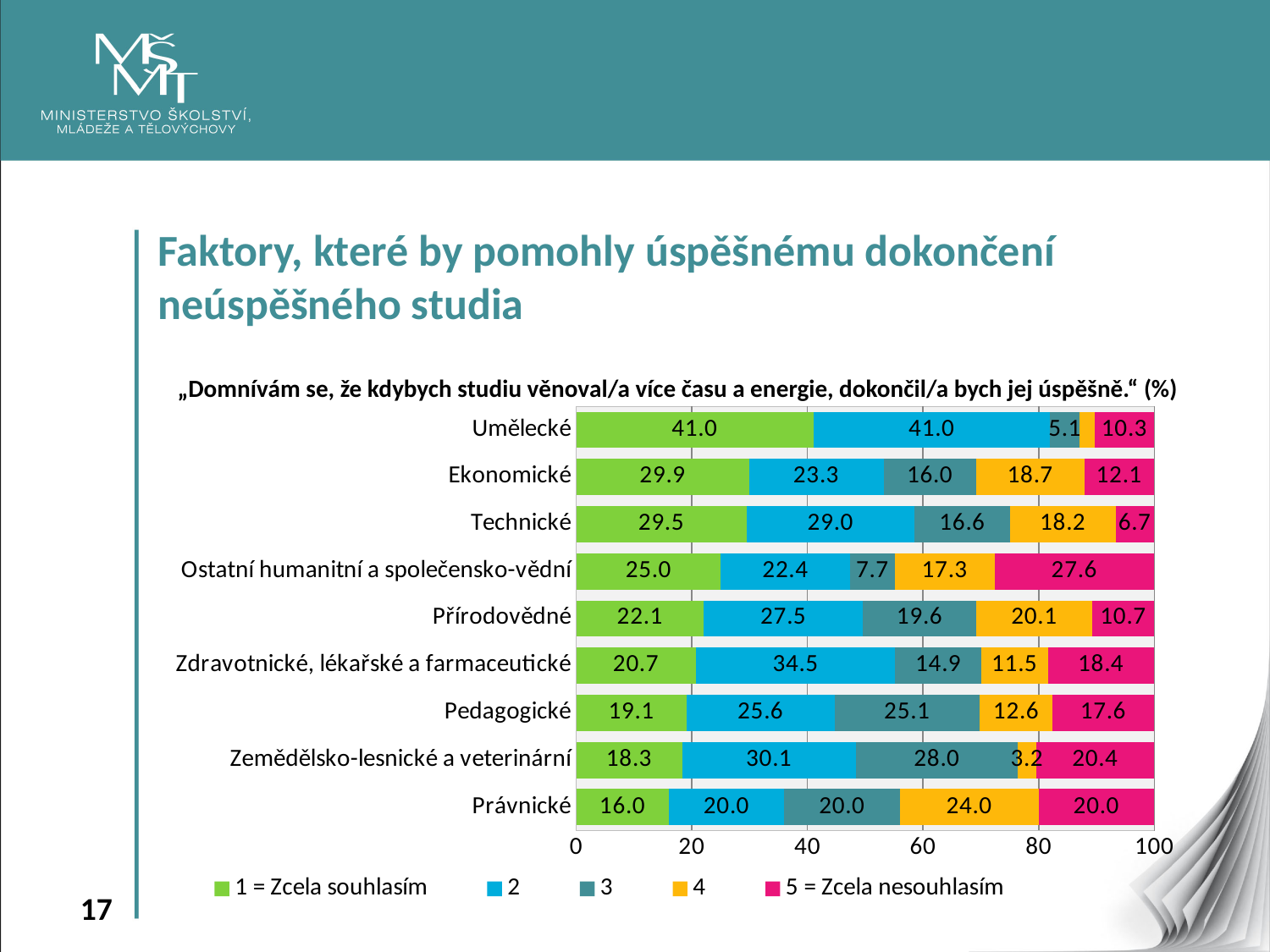
For Technické, what is the difference between the value of series "2" and series "3"? 12.4 What kind of chart is shown on the slide? Stacked bar chart What is the value of "5 = Zcela nesouhlasím" for Ostatní humanitní a společensko-vědní? 27.6 Which category has the lowest value for "1 = Zcela souhlasím"? Právnické What is the value of "1 = Zcela souhlasím" for Ekonomické? 29.9 Which category has the highest value for "1 = Zcela souhlasím"? Umělecké Which category has the highest value for "5 = Zcela nesouhlasím"? Ostatní humanitní a společensko-vědní Which has a larger value for series "2": Zdravotnické, lékařské a farmaceutické or Zemědělsko-lesnické a veterinární? Zdravotnické, lékařské a farmaceutické What is the total of the stacked bar for Právnické? 100.0 How many categories are shown on the chart? 9 How many series does the legend list? 5 What is the value of series "4" for Zemědělsko-lesnické a veterinární? 3.2